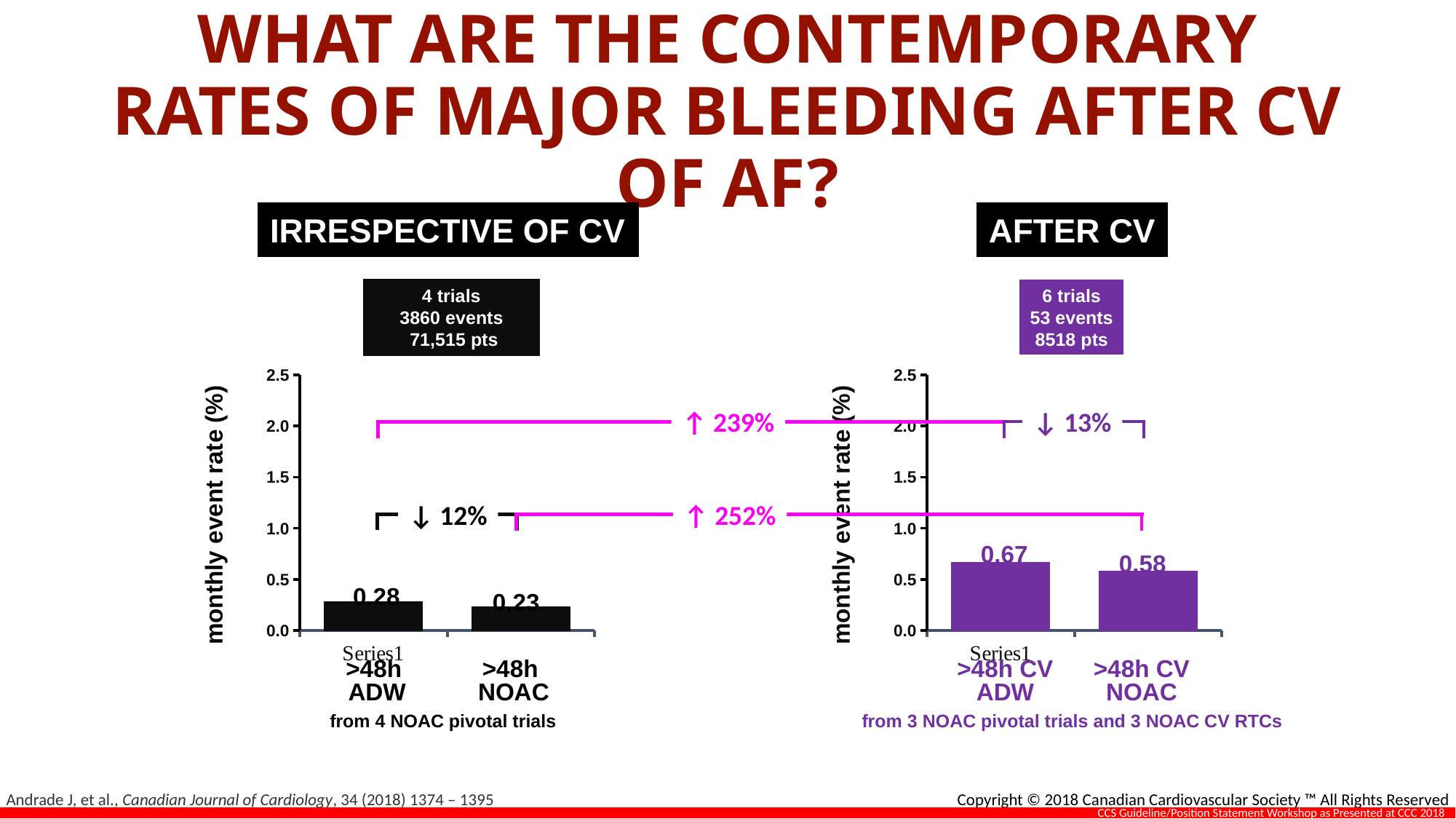
In the IRRESPECTIVE OF CV chart, what is the monthly event rate for >48h NOAC? 0.23 In the IRRESPECTIVE OF CV chart, what is the monthly event rate for >48h ADW? 0.28 What type of chart is the AFTER CV chart? bar chart Is the monthly event rate for >48h CV ADW in the AFTER CV chart larger or smaller than the rate for >48h ADW in the IRRESPECTIVE OF CV chart? larger In the AFTER CV chart, what is the monthly event rate for >48h CV NOAC? 0.58 In the AFTER CV chart, which category has the highest monthly event rate? >48h CV ADW In the AFTER CV chart, what is the difference between the monthly event rates for >48h CV ADW and >48h CV NOAC? 0.09 In the AFTER CV chart, what is the monthly event rate for >48h CV ADW? 0.67 How many bars are plotted in the IRRESPECTIVE OF CV chart? 2 In the IRRESPECTIVE OF CV chart, which category has the lowest monthly event rate? >48h NOAC In the AFTER CV chart, is the value for >48h CV NOAC greater or less than 1.0? less In the IRRESPECTIVE OF CV chart, what is the difference between the monthly event rates for >48h ADW and >48h NOAC? 0.05